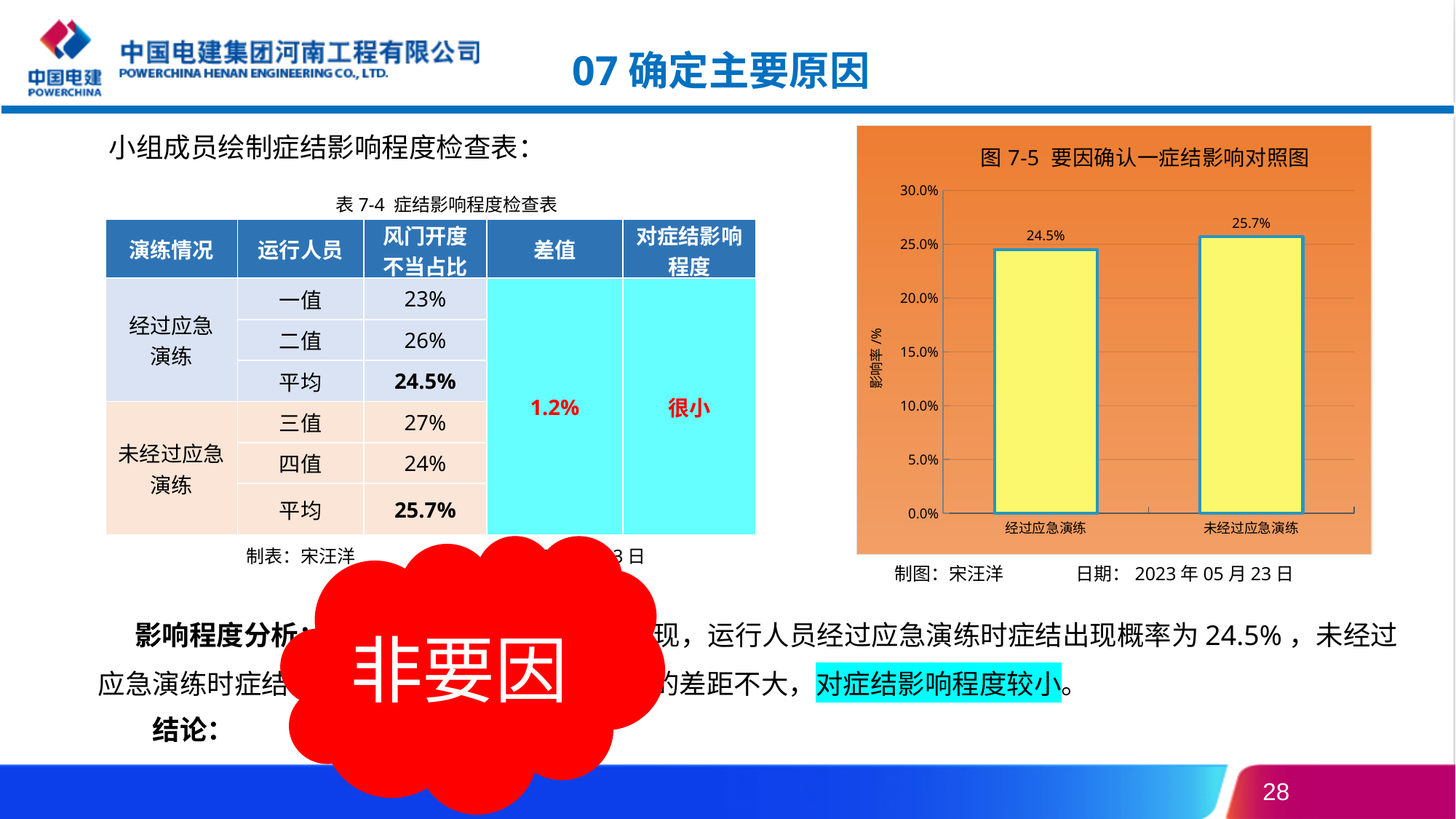
What kind of chart is shown on the slide? bar chart Which category has the lowest value in the chart? 经过应急演练 What is the label of the y axis of the chart? 影响率 /% What is the value for 经过应急演练 in the chart? 24.5% Which is larger, the value for 经过应急演练 or 未经过应急演练? 未经过应急演练 What is the value for 未经过应急演练 in the chart? 25.7% How many categories are shown on the x axis of the chart? 2 What is the difference between the values for 未经过应急演练 and 经过应急演练? 1.2% Which category has the highest value in the chart? 未经过应急演练 Is the value for 经过应急演练 greater or less than 25.0%? less What is the title of the chart? 图 7-5 要因确认一症结影响对照图 Is the value for 未经过应急演练 greater or less than 25.0%? greater